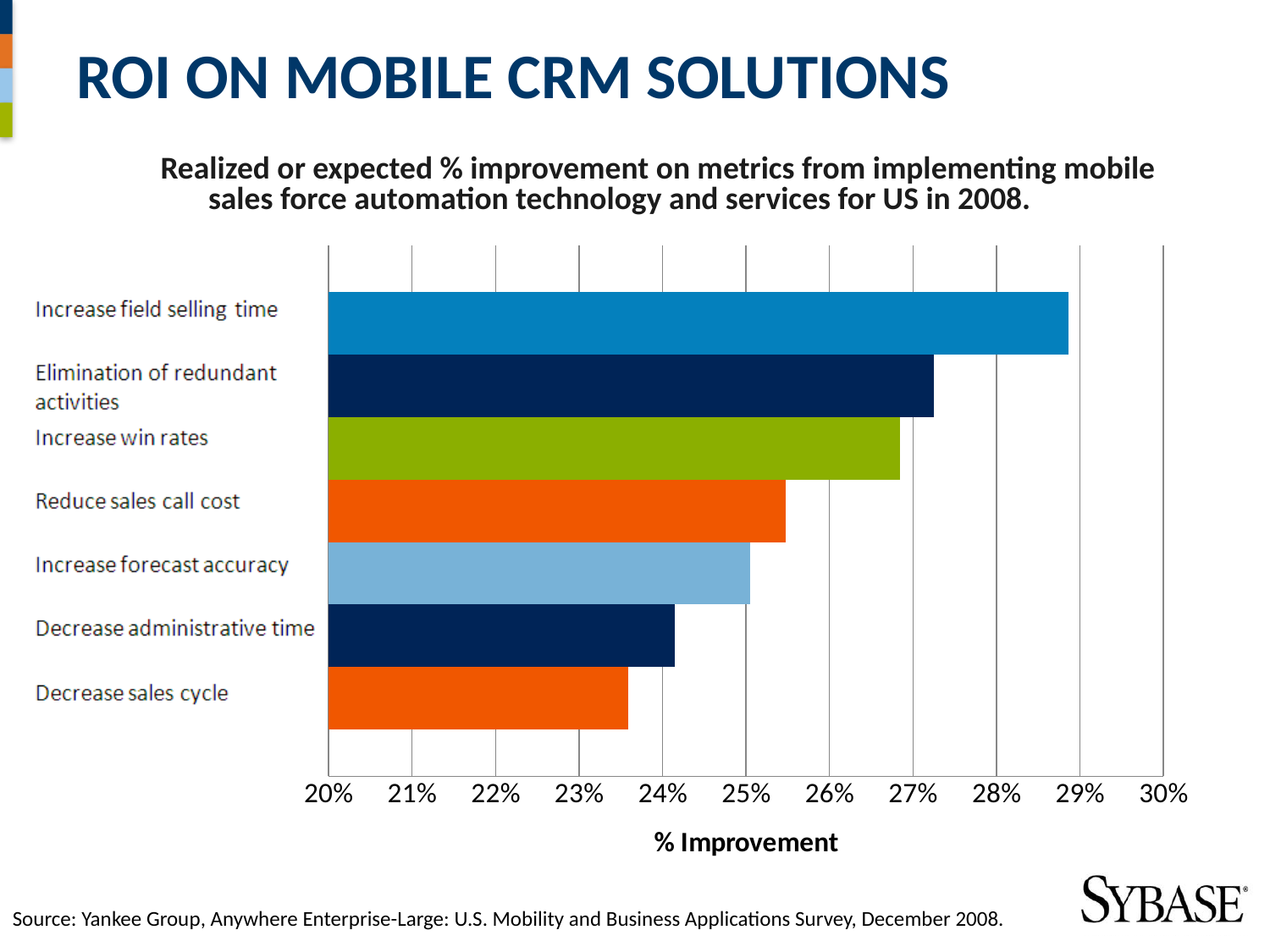
Do the bar values increase or decrease going from the top category to the bottom category? decrease Is the value for Reduce sales call cost greater or less than 25%? greater Which has a higher % improvement: Increase win rates or Reduce sales call cost? Increase win rates Is the value for Increase field selling time greater or less than 28%? greater How many metrics (categories) are plotted in the chart? 7 Which metric has the highest % improvement? Increase field selling time Is the value for Decrease administrative time greater or less than 25%? less Which metric has the lowest % improvement? Decrease sales cycle What is the title of the horizontal axis? % Improvement What kind of chart is shown on the slide? bar chart